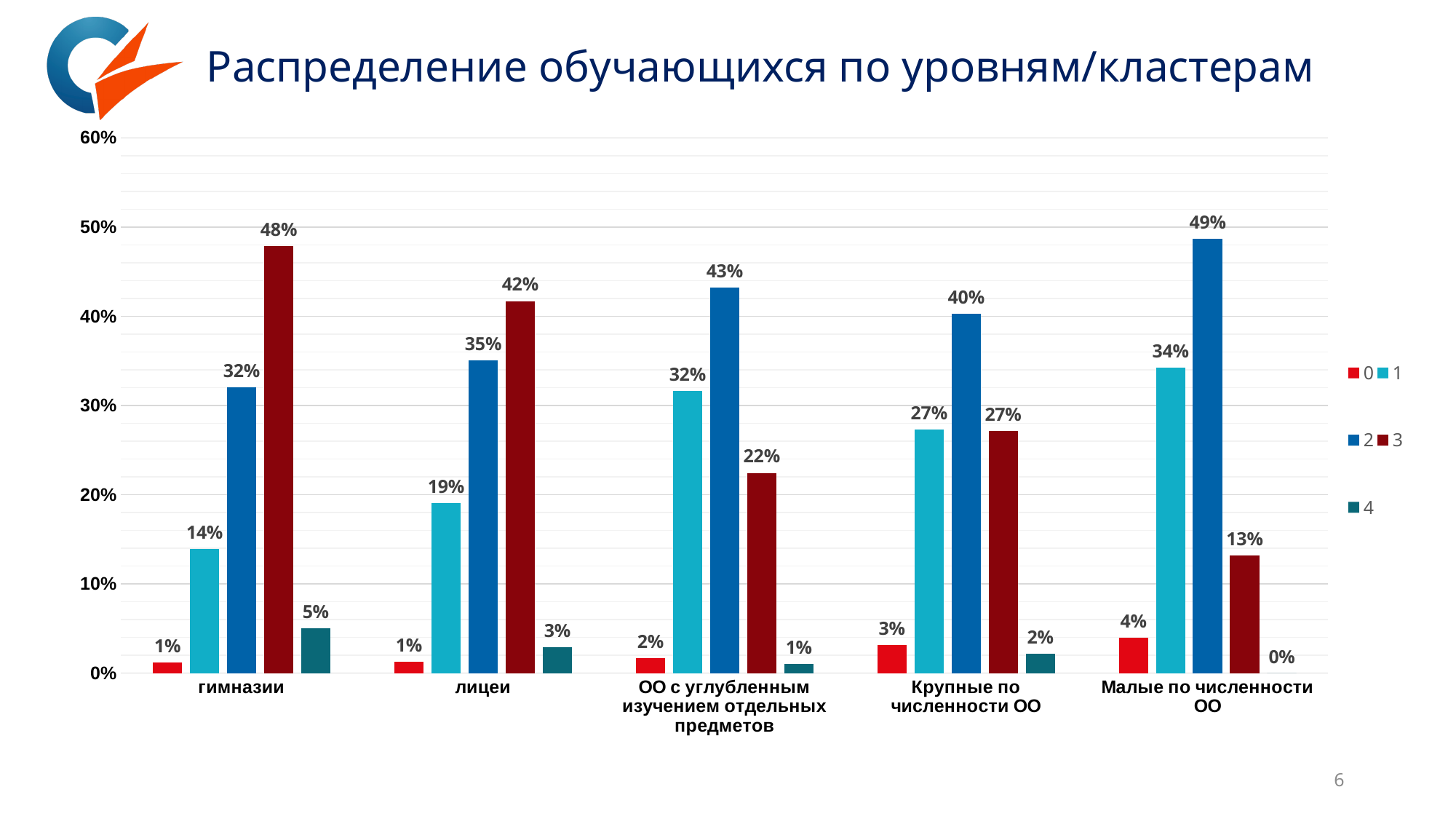
What is the difference between series 2 and series 3 in the ОО с углубленным изучением отдельных предметов category? 21% What is the title of the chart? Распределение обучающихся по уровням/кластерам What kind of chart is shown on the slide? bar chart What is the difference between series 3 and series 2 in the гимназии category? 16% How many series does the legend list? 5 Which category has the lowest value for series 4? Малые по численности ОО What is the value for series 3 in the гимназии category? 48% How many categories are shown on the x axis? 5 What is the value for series 2 in the Малые по численности ОО category? 49% Which is larger in the Крупные по численности ОО category: series 1 or series 2? series 2 What is the value for series 1 in the лицеи category? 19% Which category has the highest value for series 2? Малые по численности ОО